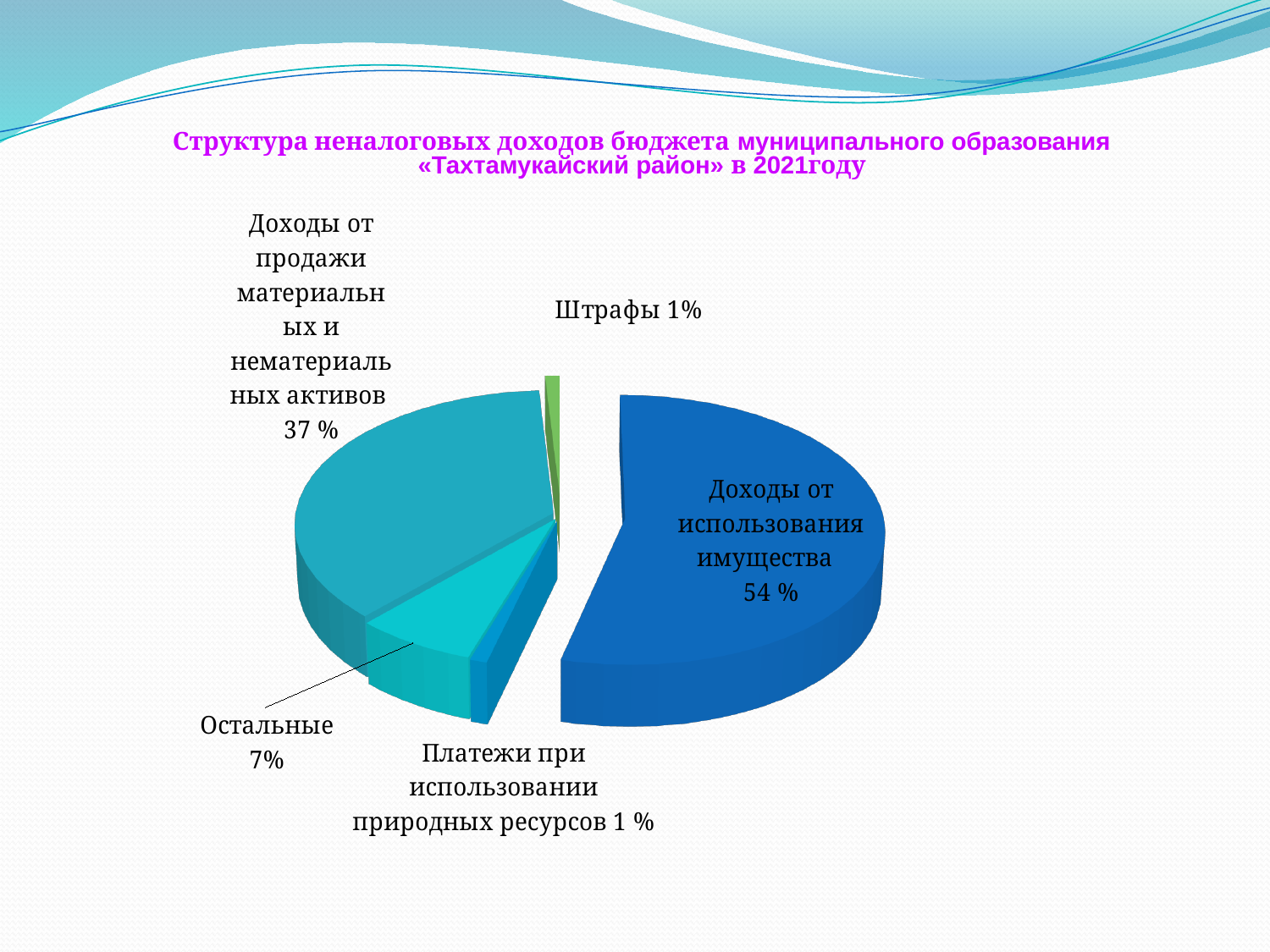
How many categories are shown in the pie chart? 5 What year does the chart title refer to? 2021 What is the value shown for «Платежи при использовании природных ресурсов»? 1 % Which category has the largest share of the pie? Доходы от использования имущества Which is larger: the share of «Остальные» or the share of «Штрафы»? Остальные What is the difference between the shares of «Доходы от использования имущества» and «Доходы от продажи материальных и нематериальных активов»? 17 % What is the difference between the shares of «Доходы от продажи материальных и нематериальных активов» and «Остальные»? 30 % What is the value shown for «Остальные»? 7% What is the value shown for «Штрафы»? 1% What is the value shown for «Доходы от продажи материальных и нематериальных активов»? 37 % What share of the pie does «Доходы от использования имущества» represent? 54 % What kind of chart is shown on the slide? Pie chart